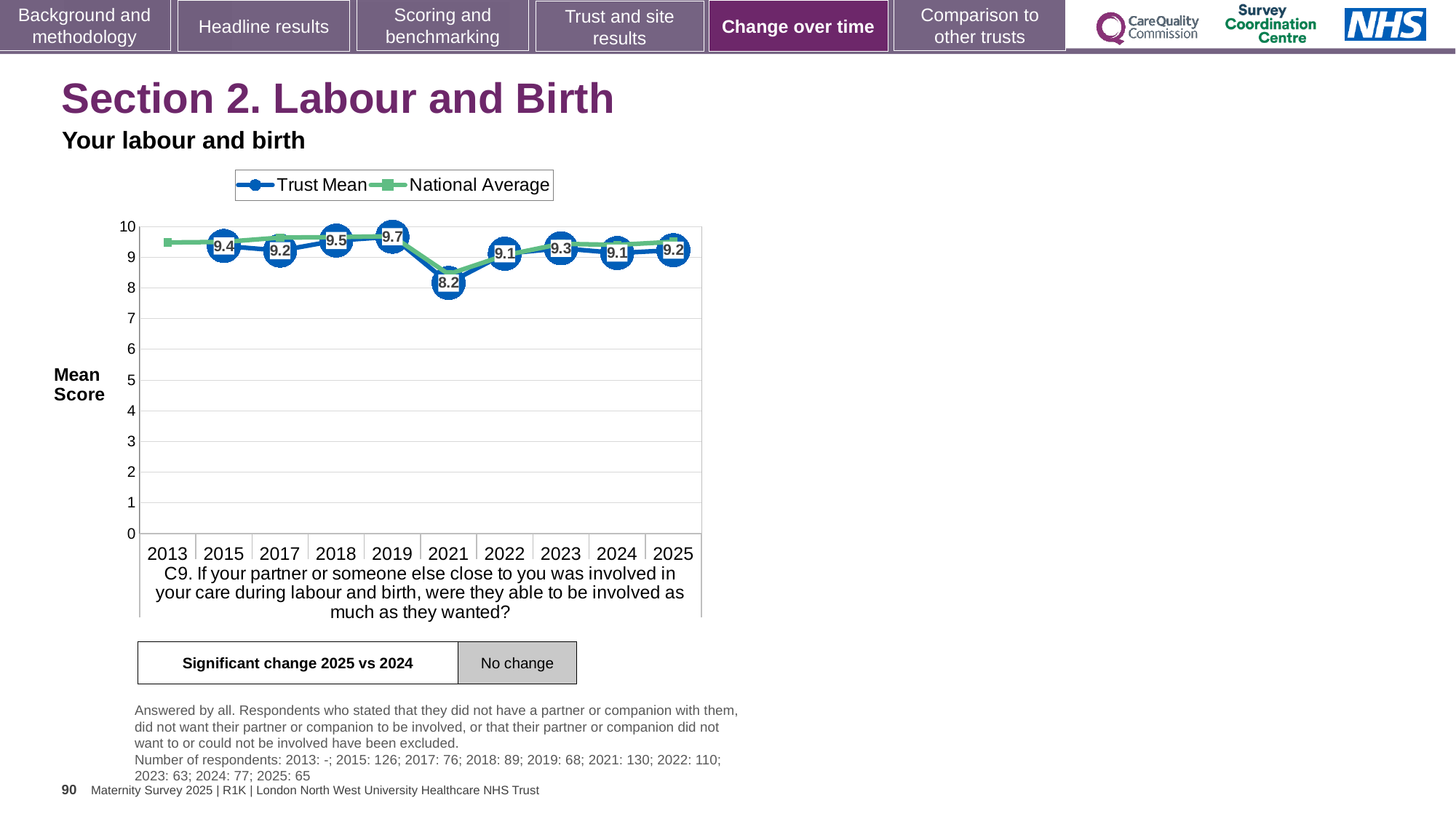
Does the Trust Mean rise or fall from 2019 to 2021? Fall What is the difference between the Trust Mean in 2019 and in 2021? 1.5 What is the Trust Mean for 2019? 9.7 Which year has the larger Trust Mean, 2018 or 2024? 2018 In which year is the Trust Mean lowest? 2021 What kind of chart is shown? Line chart In which year is the Trust Mean highest? 2019 Is the National Average for 2013 greater or less than 9? greater How many series does the legend list? 2 What is the Trust Mean for 2025? 9.2 What is the Trust Mean for 2021? 8.2 How many years are shown on the x axis? 10